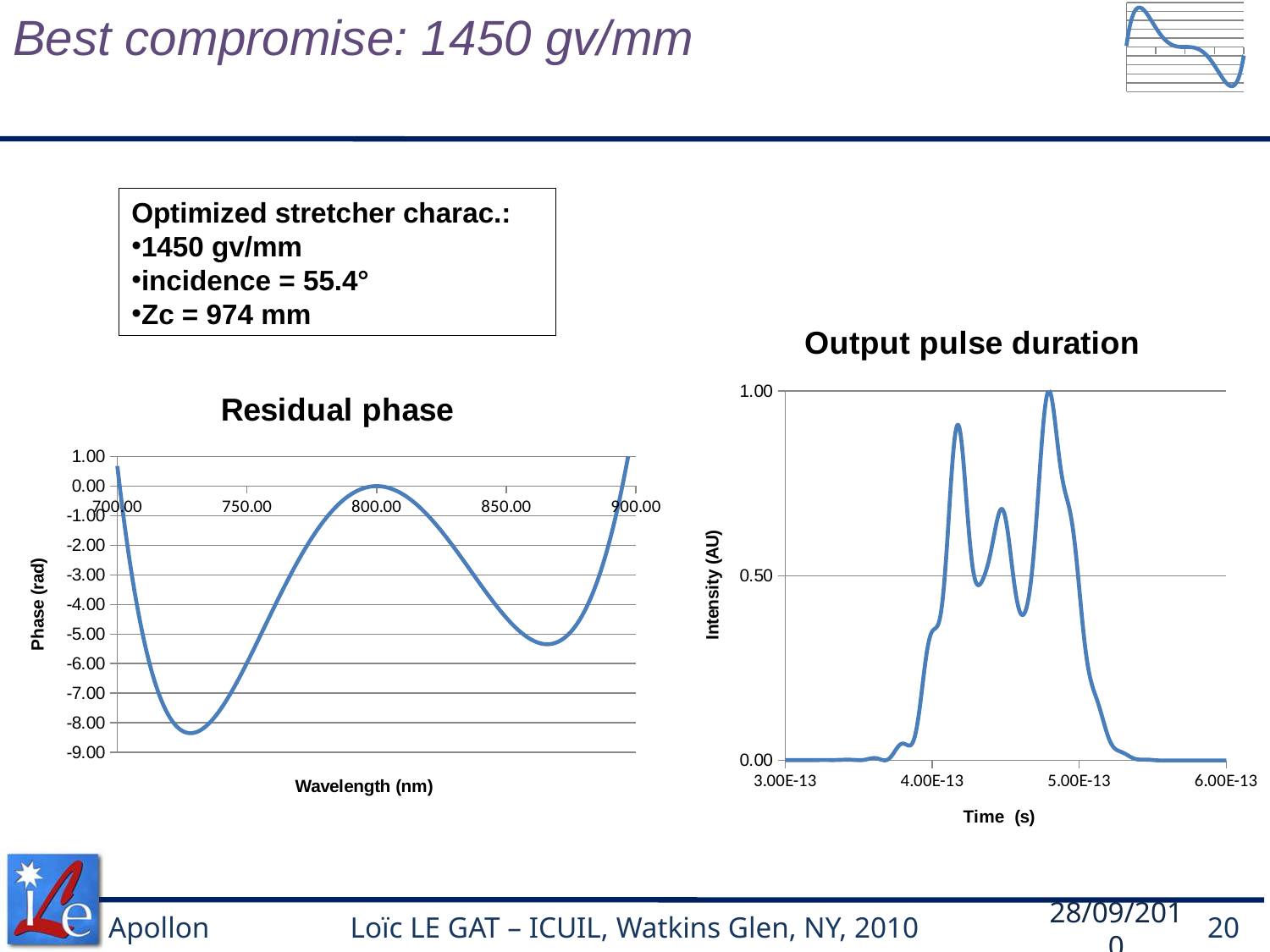
In the "Residual phase" chart, is the phase at 850.00 nm greater or less than -2.00? less In the "Residual phase" chart, what is the label of the x axis? Wavelength (nm) In the "Output pulse duration" chart, does the intensity rise or fall as time goes from 5.00E-13 s to 6.00E-13 s? fall What kind of chart is the "Output pulse duration" chart? line chart In the "Residual phase" chart, is the lowest point of the curve greater or less than -8.00? less In the "Output pulse duration" chart, what is the label of the y axis? Intensity (AU) In the "Residual phase" chart, does the phase rise or fall as the wavelength goes from 750.00 nm to 800.00 nm? rise What kind of chart is the "Residual phase" chart? line chart In the "Output pulse duration" chart, is the highest peak of the curve greater or less than 0.50? greater